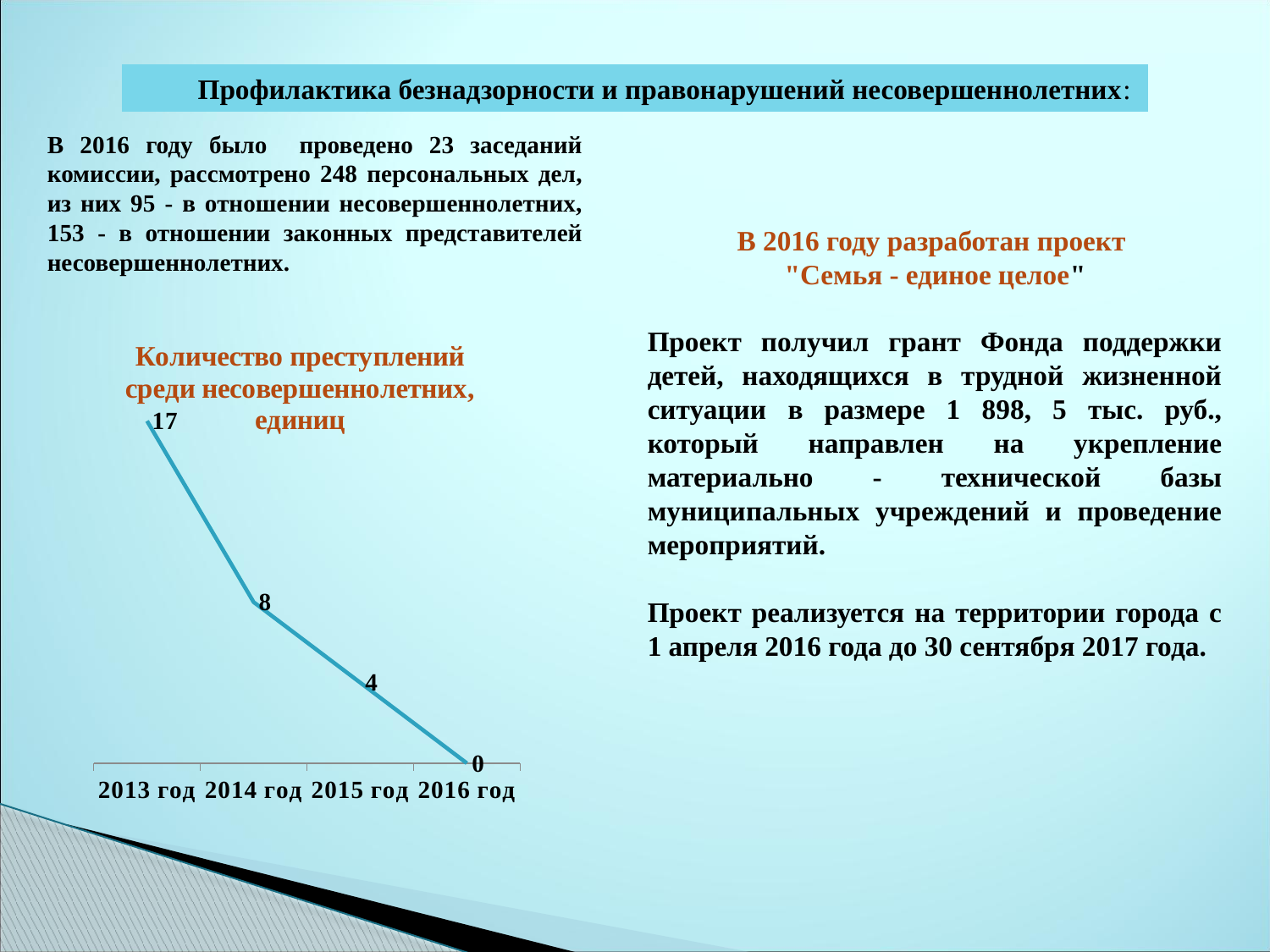
What is the value for 2013 год? 17 Which is larger, the value for 2014 год or the value for 2015 год? 2014 год What type of chart is shown on the slide? line chart What is the difference between the values for 2013 год and 2014 год? 9 Which year has the lowest number of crimes among minors? 2016 год What is the value for 2014 год? 8 What is the value for 2015 год? 4 How many years are plotted on the chart? 4 What is the difference between the values for 2014 год and 2015 год? 4 Which year has the highest number of crimes among minors? 2013 год What is the value for 2016 год? 0 Do the values rise or fall from 2013 год to 2016 год? fall